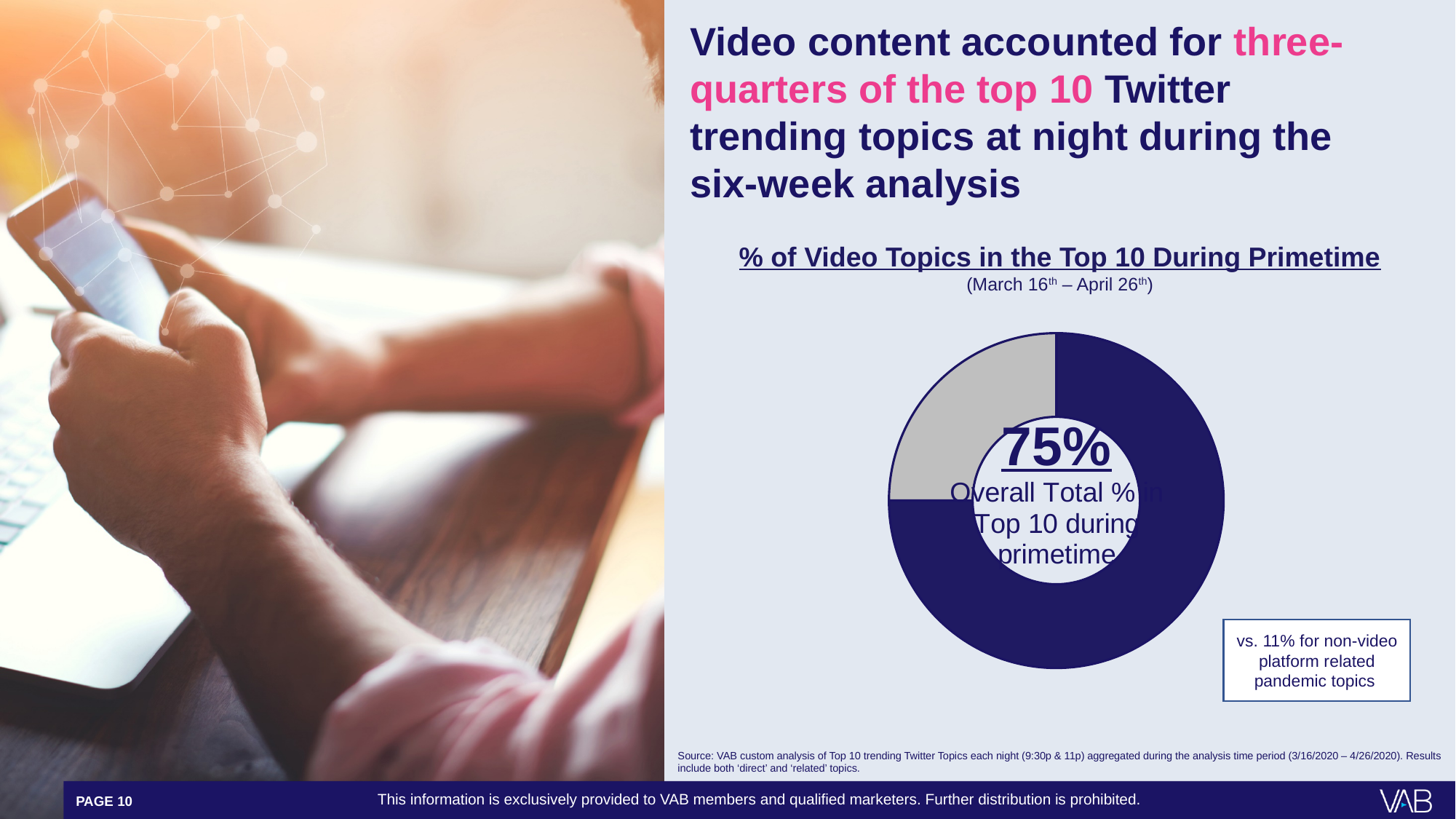
What kind of chart is shown on the slide? donut chart Which is larger: the 75% for video topics or the 11% for non-video platform related pandemic topics? 75% for video topics What date range is shown under the chart title? March 16th – April 26th What percentage is printed in the centre of the donut chart? 75% According to the chart, what is the overall total % of video topics in the Top 10 during primetime? 75% Which slice of the donut chart is larger, the dark blue one or the grey one? dark blue What is the title of the chart? % of Video Topics in the Top 10 During Primetime What percentage is given in the box next to the chart for non-video platform related pandemic topics? 11% What is the difference between the 75% for video topics and the 11% for non-video platform related pandemic topics? 64 percentage points What share of the donut chart does the dark blue slice represent? 75% How many slices does the donut chart have? 2